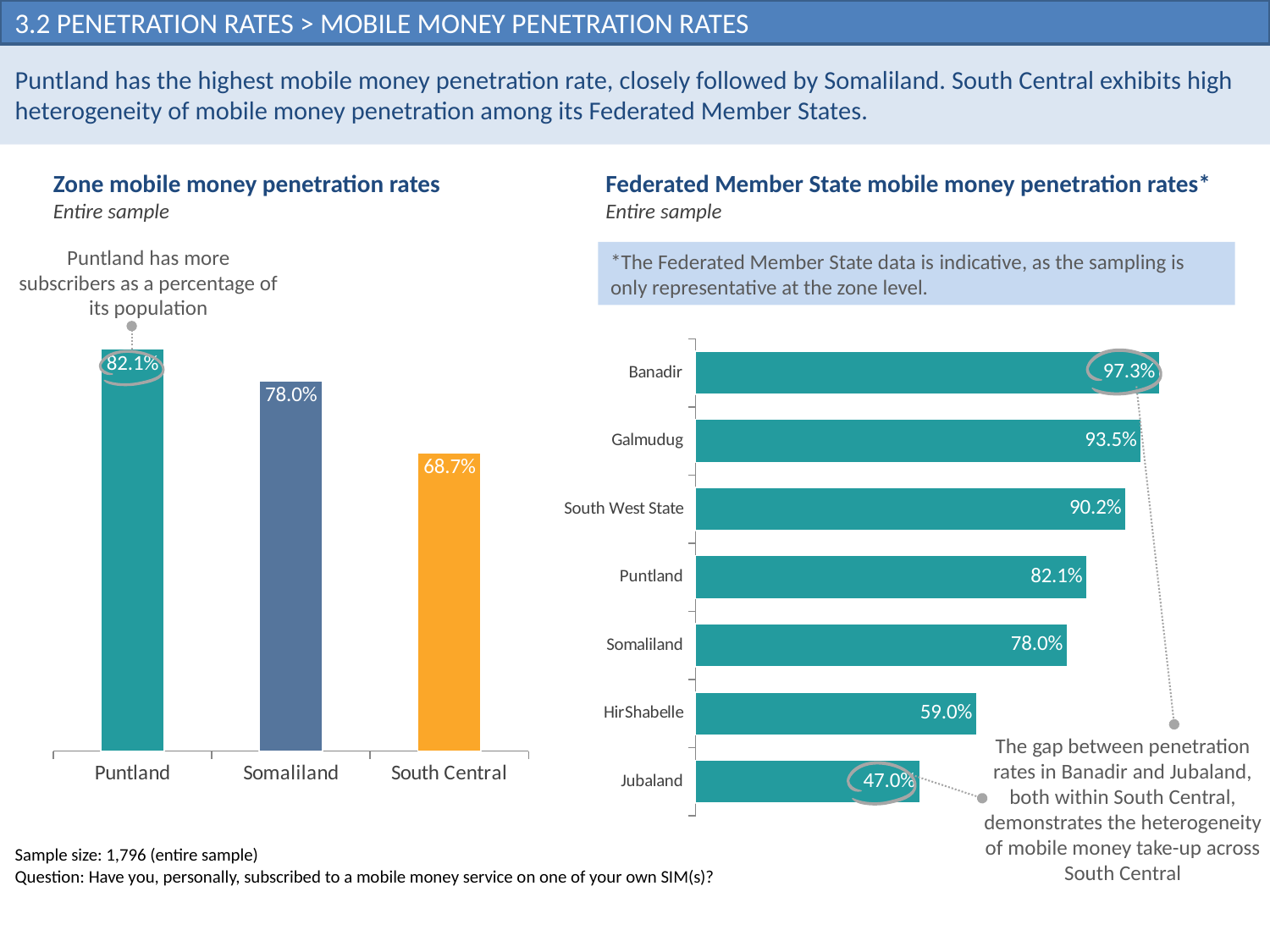
In the 'Federated Member State mobile money penetration rates' chart, what is the difference between Banadir and Jubaland? 50.3% What kind of chart is the 'Zone mobile money penetration rates' chart? Bar chart In the 'Federated Member State mobile money penetration rates' chart, what is the value for Galmudug? 93.5% In the 'Federated Member State mobile money penetration rates' chart, which is larger, South West State or HirShabelle? South West State In the 'Federated Member State mobile money penetration rates' chart, which state has the lowest penetration rate? Jubaland In the 'Federated Member State mobile money penetration rates' chart, how many states are shown? 7 In the 'Zone mobile money penetration rates' chart, what is the difference between Puntland and South Central? 13.4% In the 'Zone mobile money penetration rates' chart, what colour is the South Central bar? Orange In the 'Zone mobile money penetration rates' chart, how many zones are shown? 3 In the 'Zone mobile money penetration rates' chart, what is the value for Somaliland? 78.0% In the 'Zone mobile money penetration rates' chart, which zone has the lowest penetration rate? South Central In the 'Federated Member State mobile money penetration rates' chart, which state has the highest penetration rate? Banadir